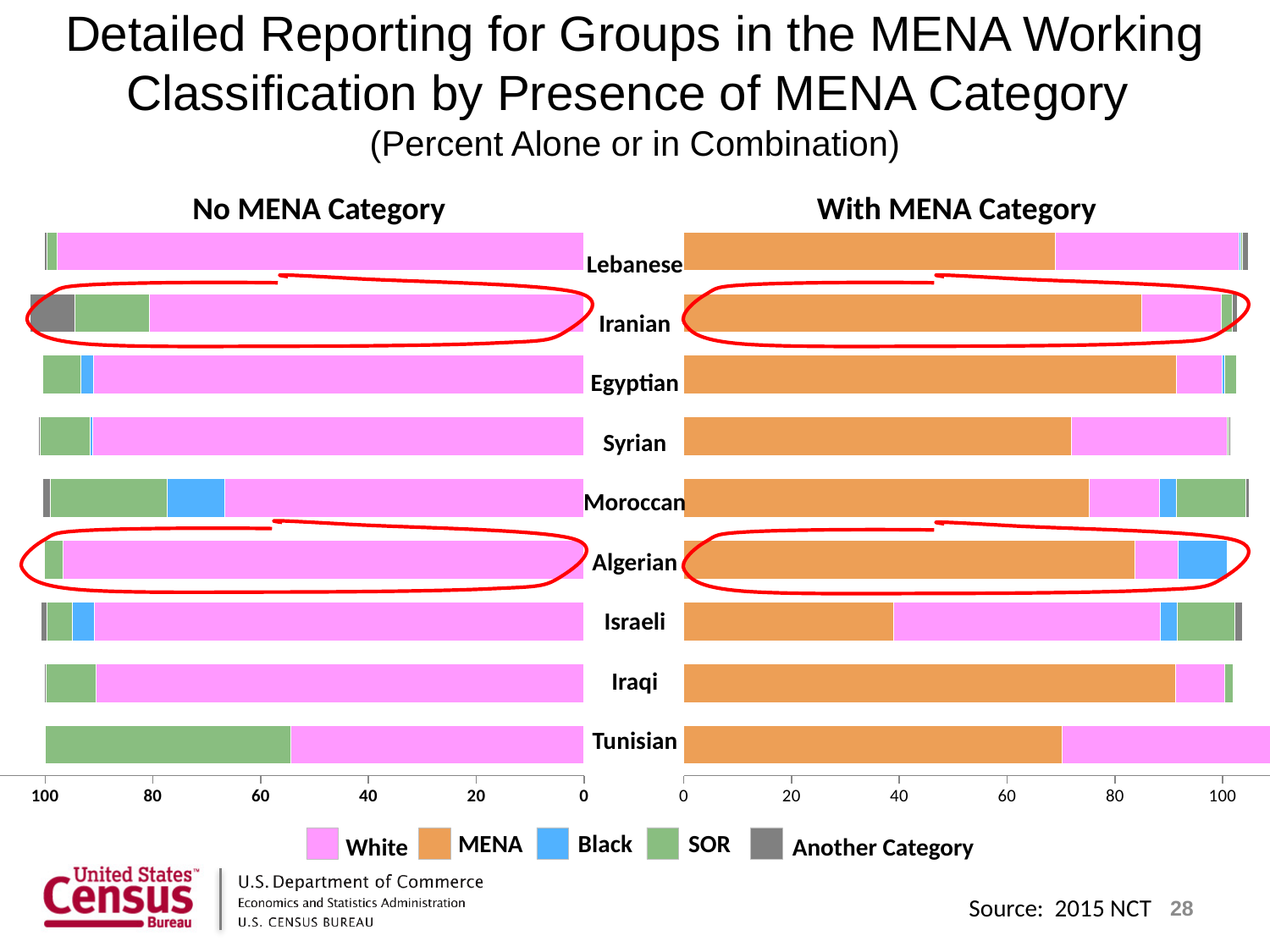
In the "No MENA Category" chart, which group has the largest SOR segment? Tunisian How many groups (categories) are shown on the "With MENA Category" chart? 9 In the "With MENA Category" chart, which group has a larger MENA segment, Egyptian or Israeli? Egyptian In the "With MENA Category" chart, is the MENA segment for Israeli greater or less than 60? less How many series does the legend list? 5 In the "No MENA Category" chart, is the Black segment for Moroccan greater or less than 20? less Which colour represents the MENA series in the legend? orange In the "With MENA Category" chart, is the MENA segment for Egyptian greater or less than 80? greater What is the title of the chart on the right side of the slide? With MENA Category In the "With MENA Category" chart, which group has the smallest MENA segment? Israeli What kind of chart is the "No MENA Category" chart? stacked bar chart